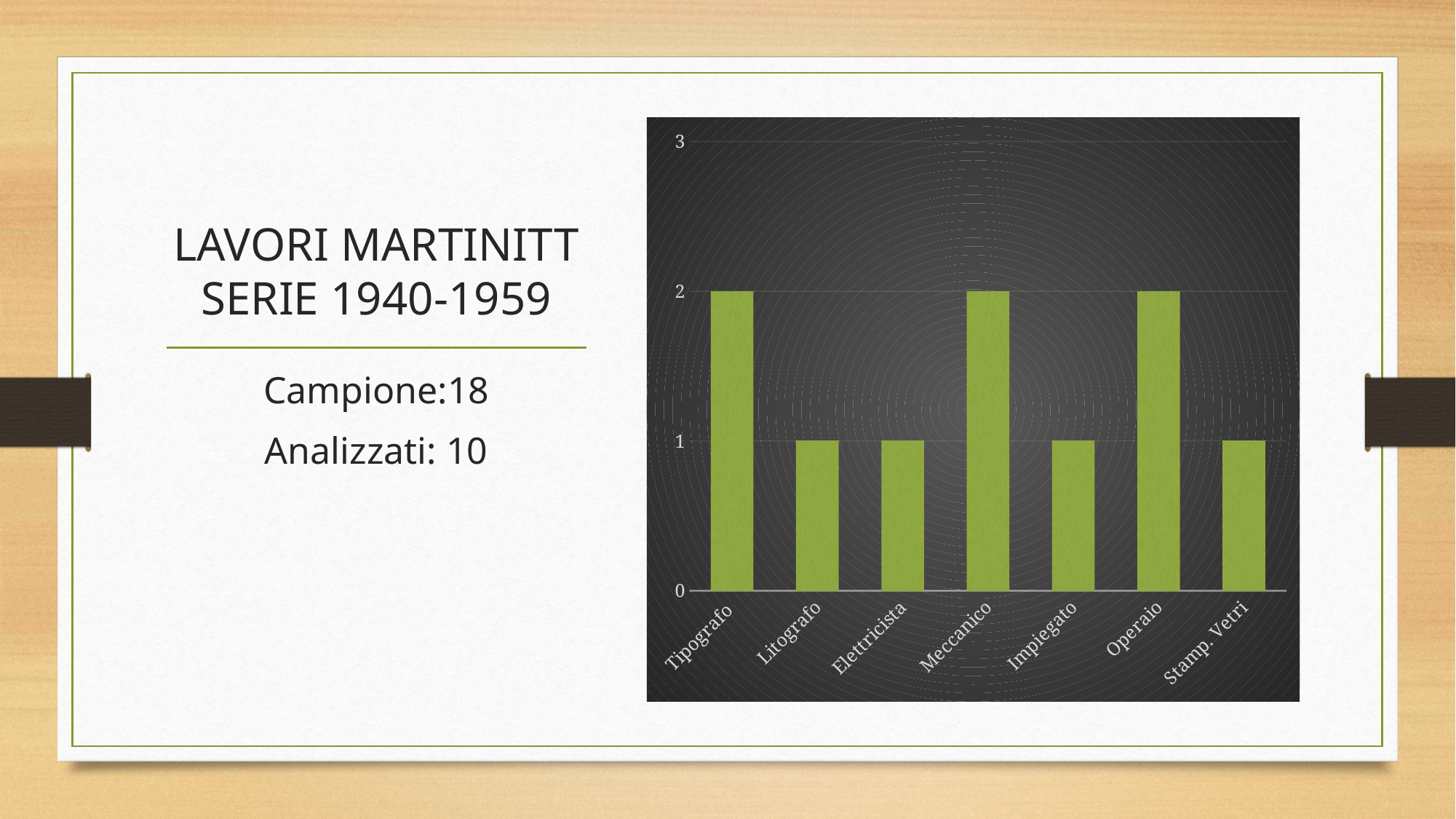
What is the value for Tipografo? 2 Is the value for Tipografo greater or less than 3? less Which is larger, the value for Operaio or the value for Elettricista? Operaio How many categories are shown on the x axis of the chart? 7 What is the value for Stamp. Vetri? 1 What type of chart is shown on the slide? bar chart What is the value for Impiegato? 1 What is the highest value shown on the vertical axis of the chart? 3 How many categories have a value of 2? 3 What is the value for Litografo? 1 What is the value for Meccanico? 2 What is the difference between the value for Meccanico and the value for Impiegato? 1